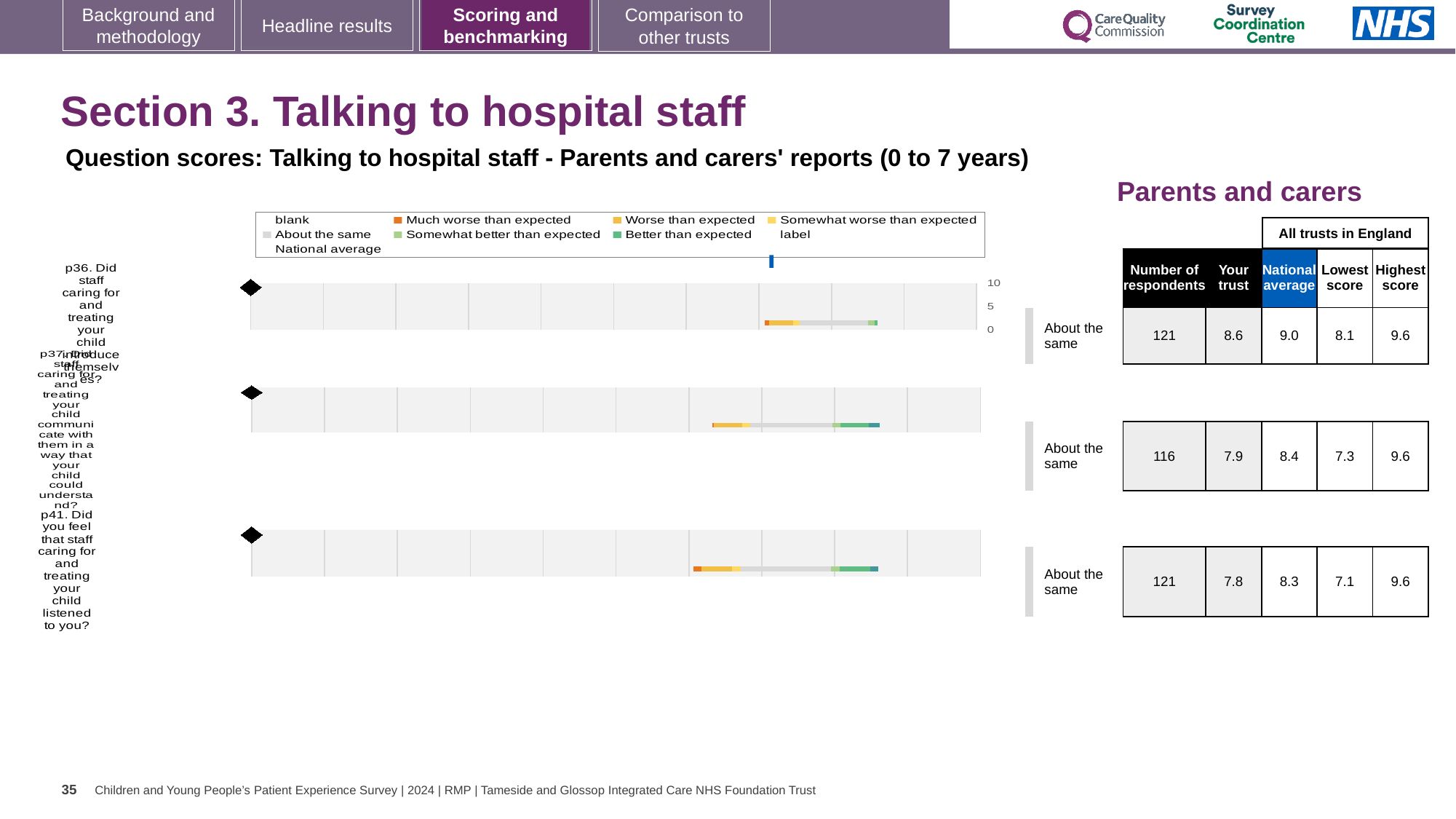
What colour does the legend use for 'Much worse than expected'? Orange Which question has the lowest 'Your trust' score? p41 What is the national average score for p37 (Did staff communicate with your child in a way they could understand)? 8.4 What is the difference between the national average and the 'Your trust' score for p36? 0.4 Which question has the highest 'Your trust' score? p36 What benchmark category is shown next to the bar for p41? About the same What is the highest score among all trusts in England for p36? 9.6 What is the 'Your trust' score for p36 (Did staff caring for and treating your child introduce themselves)? 8.6 For p37, which is larger: the 'Your trust' score or the national average? National average What type of chart is shown on the slide? bar chart How many question rows (bars) does the chart show? 3 How many respondents answered p41 (Did you feel that staff listened to you)? 121